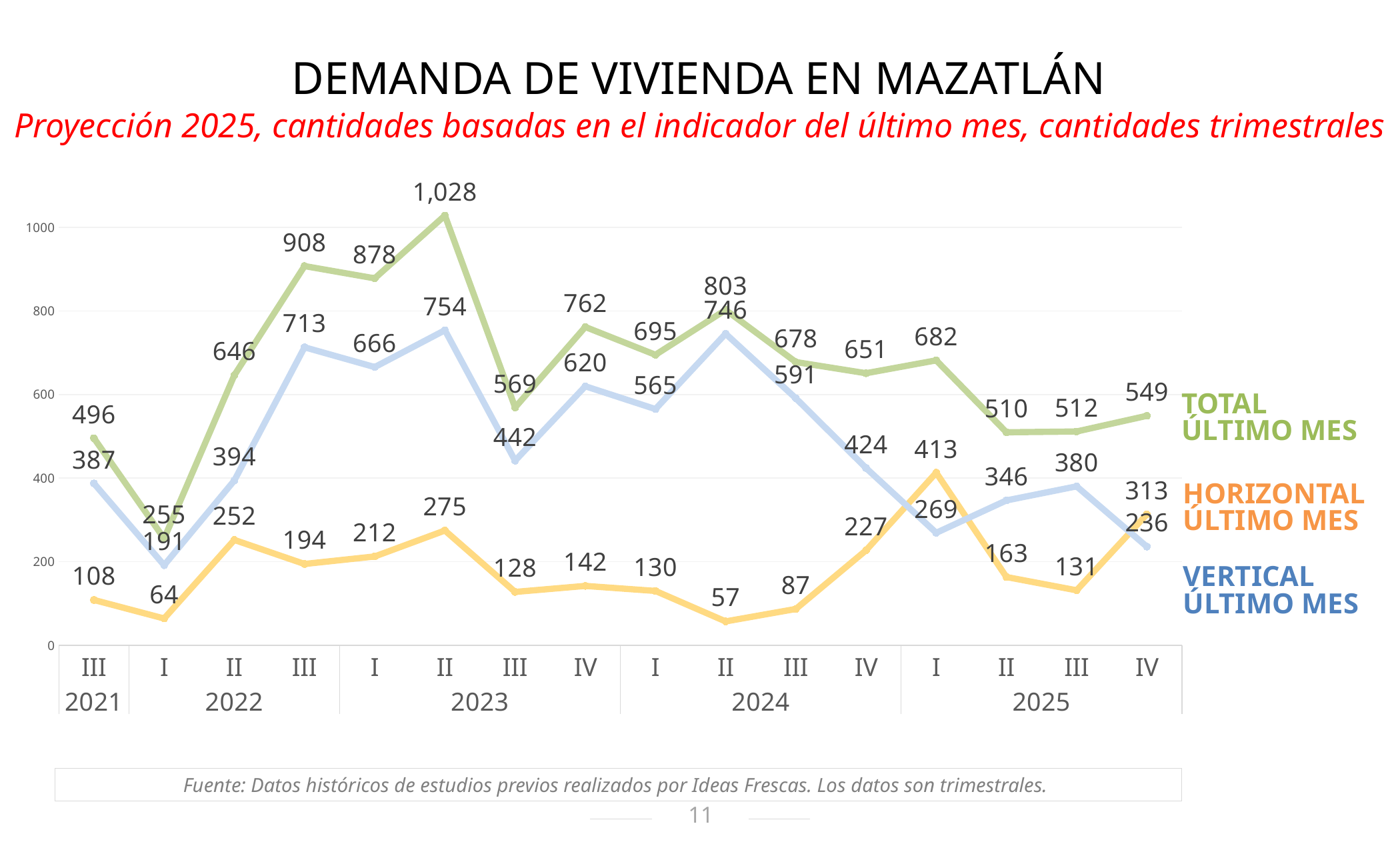
Does TOTAL ÚLTIMO MES rise or fall from quarter II of 2023 to quarter III of 2023? Fall What is the value of TOTAL ÚLTIMO MES in quarter II of 2023? 1,028 What is the difference between TOTAL ÚLTIMO MES and VERTICAL ÚLTIMO MES in quarter IV of 2025? 313 What is the value of HORIZONTAL ÚLTIMO MES in quarter I of 2025? 413 What kind of chart is shown on the slide? Line chart How many quarters are plotted on the x axis? 16 How many series does the chart show? 3 Which colour is used for the VERTICAL ÚLTIMO MES line? Blue What is the value of VERTICAL ÚLTIMO MES in quarter III of 2022? 713 Which is larger in quarter I of 2025: HORIZONTAL ÚLTIMO MES or VERTICAL ÚLTIMO MES? HORIZONTAL ÚLTIMO MES In which quarter does HORIZONTAL ÚLTIMO MES reach its lowest value? II 2024 In which quarter does TOTAL ÚLTIMO MES reach its highest value? II 2023